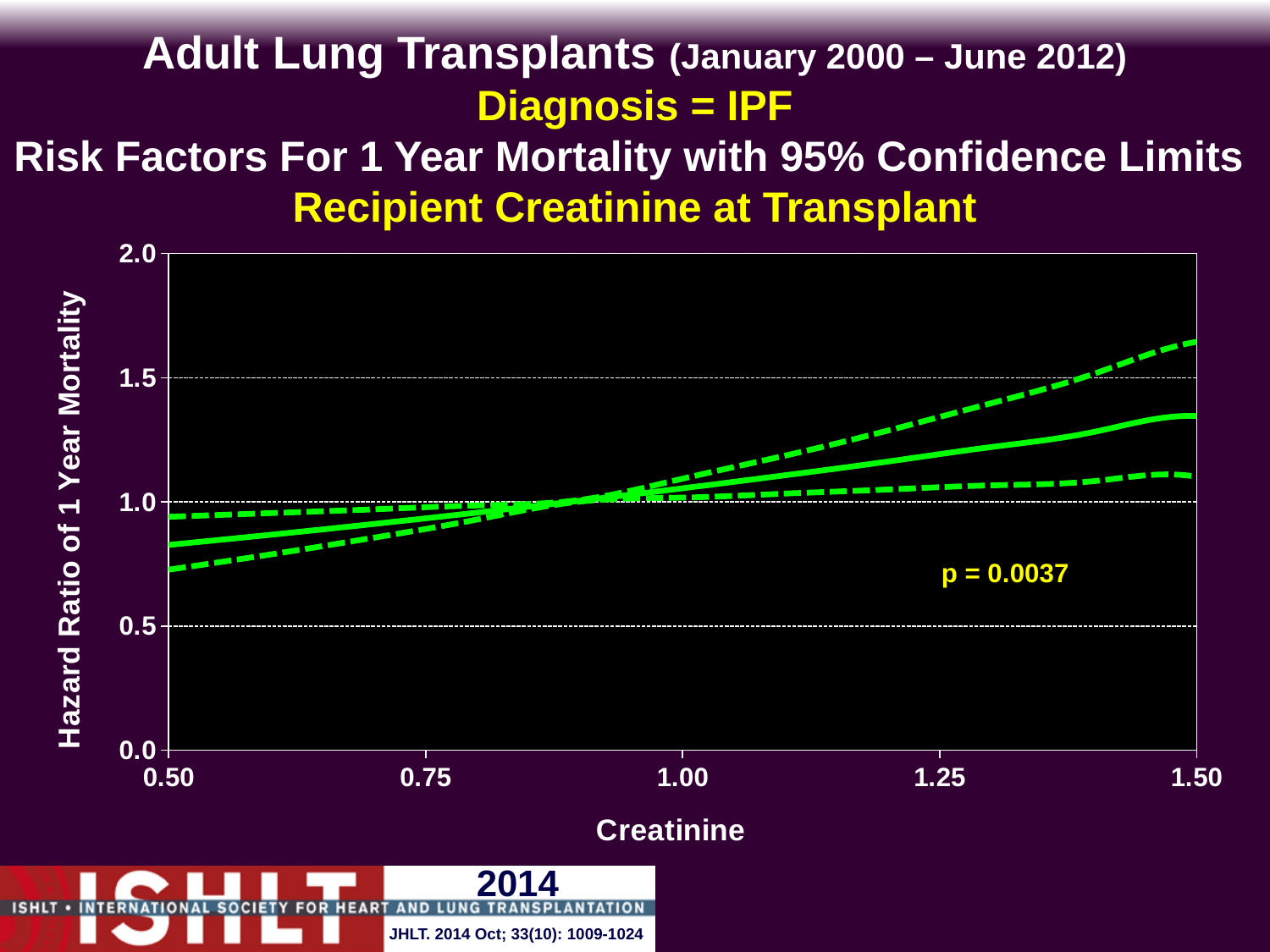
What is the label of the y axis? Hazard Ratio of 1 Year Mortality What kind of chart is shown on the slide? line chart Is the hazard ratio (solid line) at a creatinine of 1.50 greater or less than 1.5? less Does the solid hazard ratio line rise or fall as creatinine increases from 0.50 to 1.50? rise How many lines are plotted on the chart? 3 What p-value is printed on the chart? p = 0.0037 Is the hazard ratio (solid line) at a creatinine of 0.50 greater or less than 1.0? less Is the hazard ratio (solid line) at a creatinine of 1.50 greater or less than 1.0? greater How many tick labels are shown on the x axis? 5